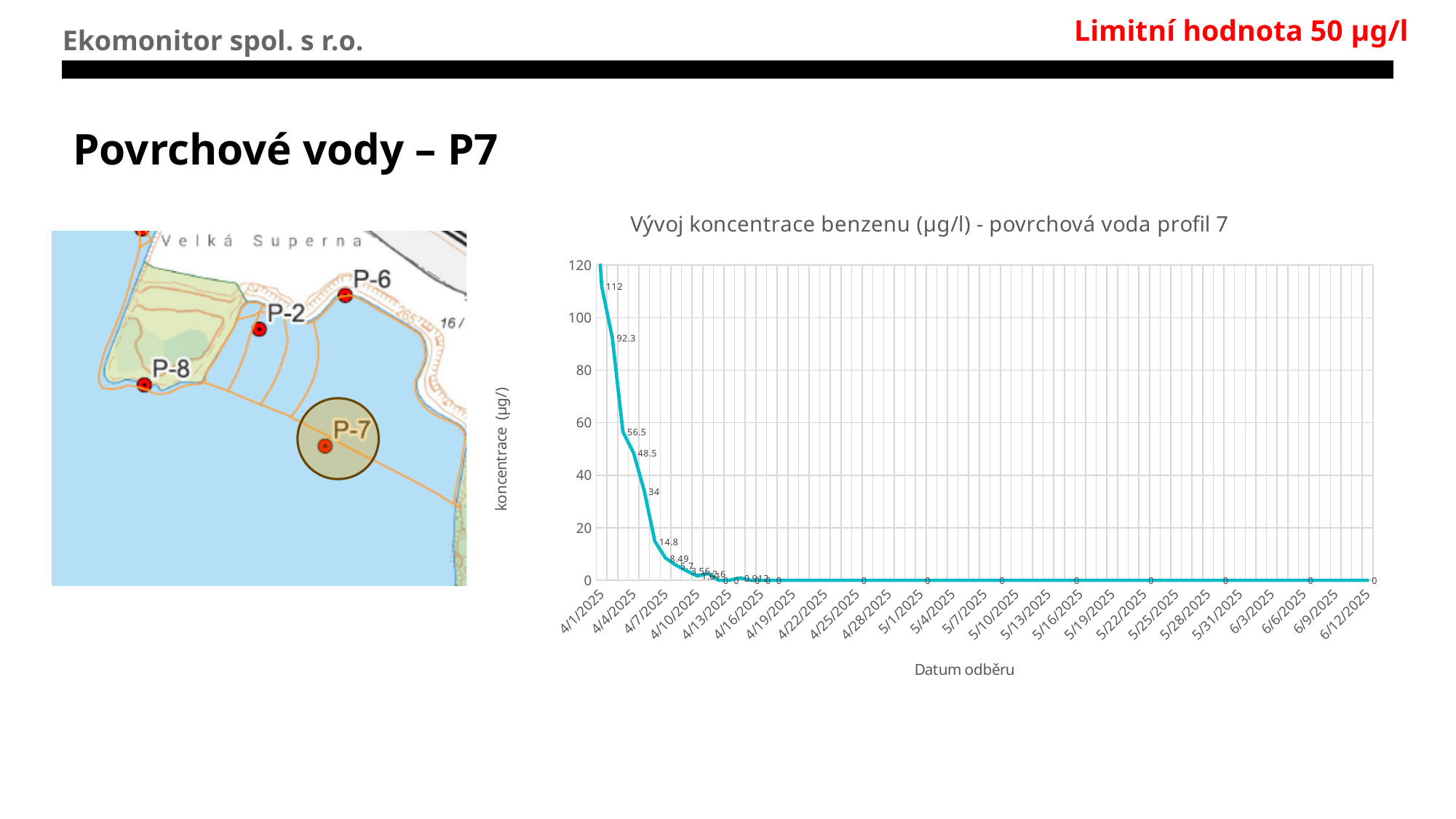
Is the value for 4/1/2025 greater or less than 100? greater What is the value plotted at the last date, 6/12/2025? 0 What is the highest value plotted on the chart? 112 What is the difference between the first plotted value (112) and the second plotted value (92.3)? 19.7 What is the benzene concentration value at the first data point (4/1/2025)? 112 What is the lowest value plotted on the chart? 0 What is the title of the chart? Vývoj koncentrace benzenu (µg/l) - povrchová voda profil 7 Is the value for 5/1/2025 greater or less than 20? less What is the label of the x axis of the chart? Datum odběru What type of chart is shown on the slide? line chart Which is larger, the value at 4/1/2025 or the value at 6/12/2025? 4/1/2025 Do the values rise or fall along the x axis from 4/1/2025 onward? fall